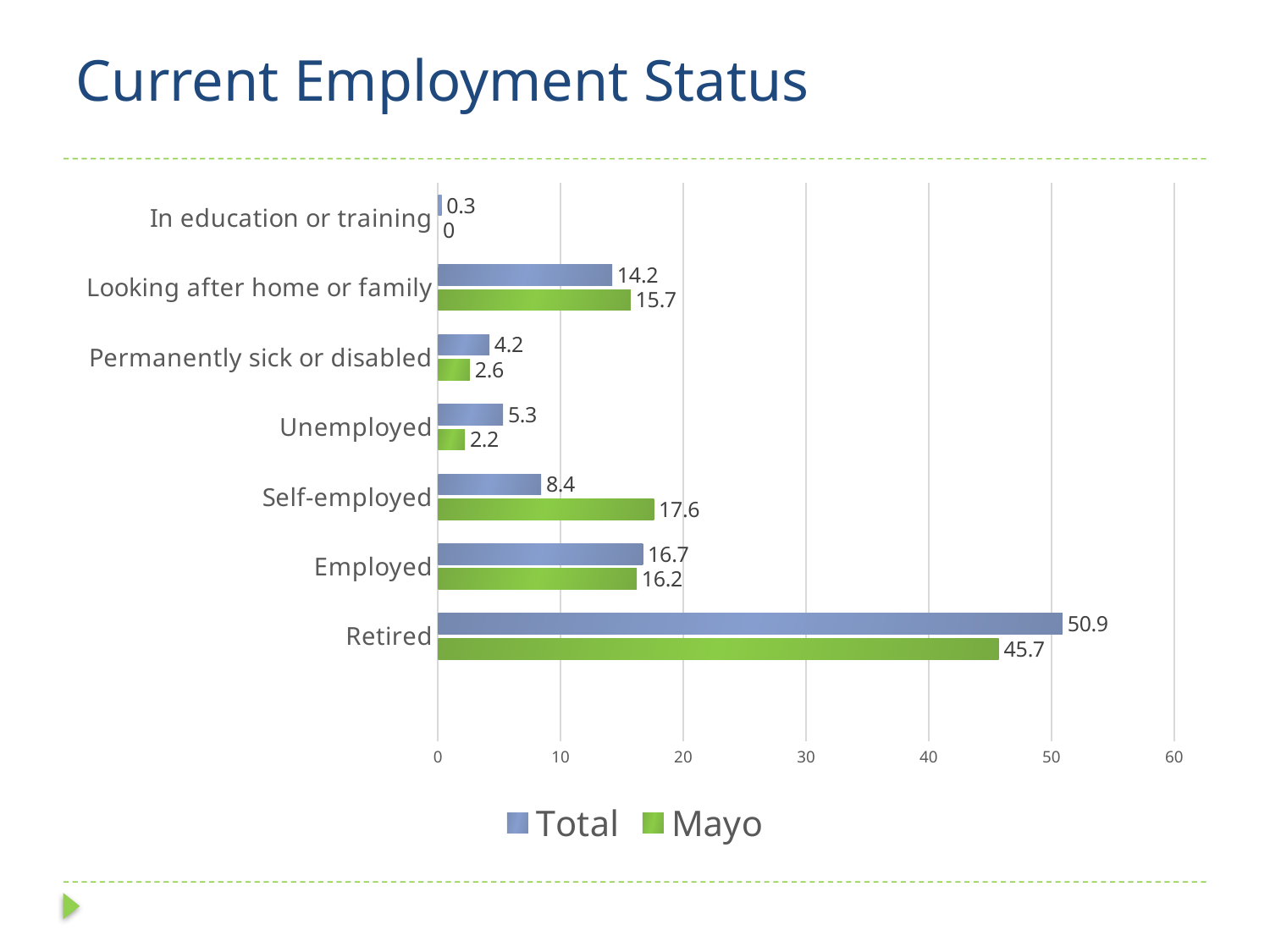
What is the Mayo value for Self-employed? 17.6 Which is larger for Self-employed, the Total value or the Mayo value? Mayo How many employment status categories are shown on the chart? 7 Is the Mayo value for Retired greater or less than 40? greater Which category has the highest Mayo value? Retired What kind of chart is shown on the slide? Bar chart How many series does the legend list? 2 Which category has the lowest Total value? In education or training Which colour represents the Mayo series? Green What is the Total value for Retired? 50.9 What is the difference between the Total and Mayo values for Retired? 5.2 What is the Mayo value for In education or training? 0